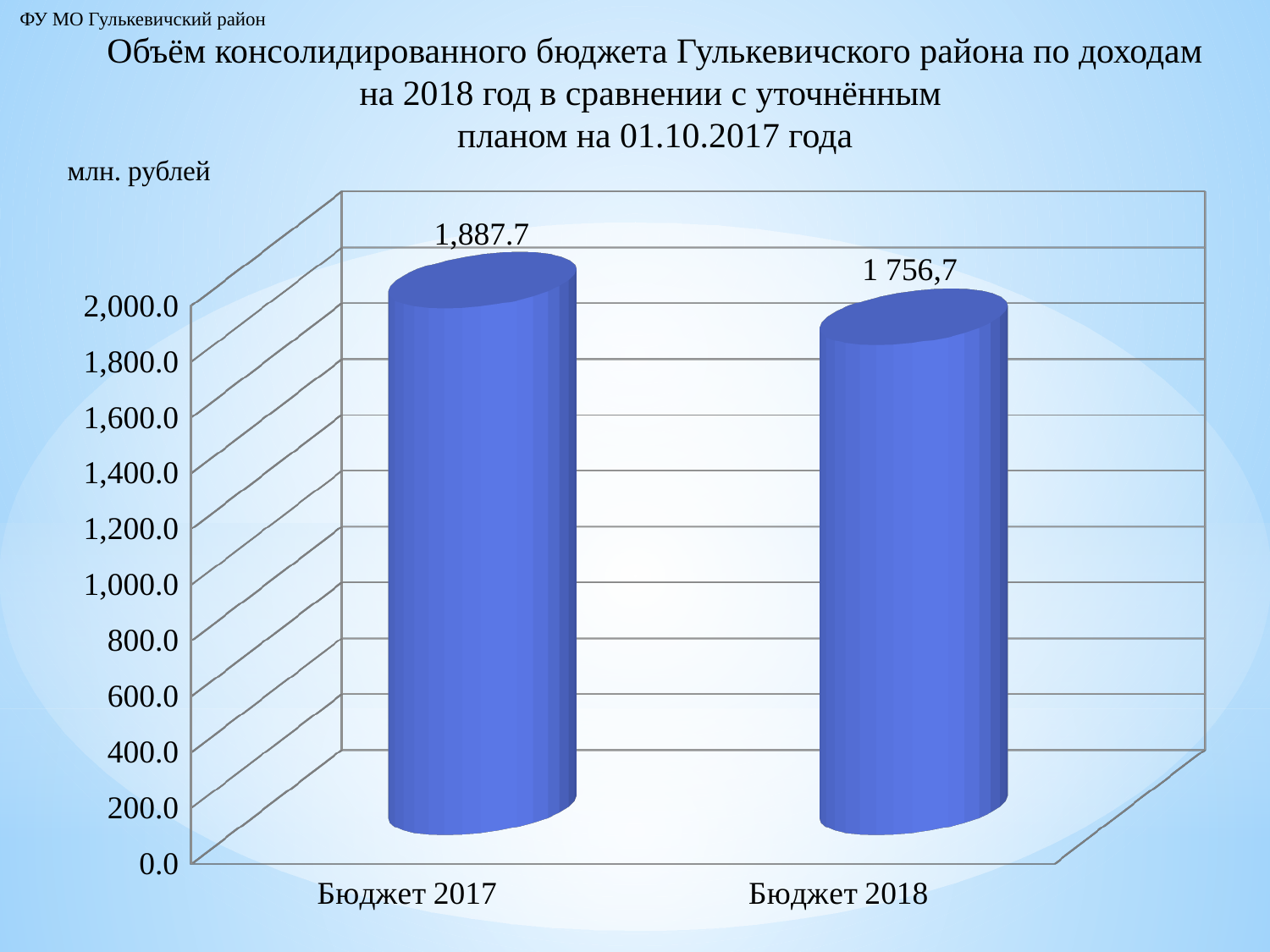
How many categories are shown on the chart? 2 Which category has the lowest value? Бюджет 2018 Do the values rise or fall from Бюджет 2017 to Бюджет 2018? fall What unit is shown for the values on the chart? млн. рублей Which is larger, the value for Бюджет 2017 or the value for Бюджет 2018? Бюджет 2017 Which category has the highest value? Бюджет 2017 What kind of chart is shown on the slide? bar chart What is the difference between the values for Бюджет 2017 and Бюджет 2018? 131.0 Is the value for Бюджет 2017 greater or less than 1,800.0? greater What is the value for Бюджет 2017? 1,887.7 What is the value for Бюджет 2018? 1 756,7 Is the value for Бюджет 2018 greater or less than 1,800.0? less